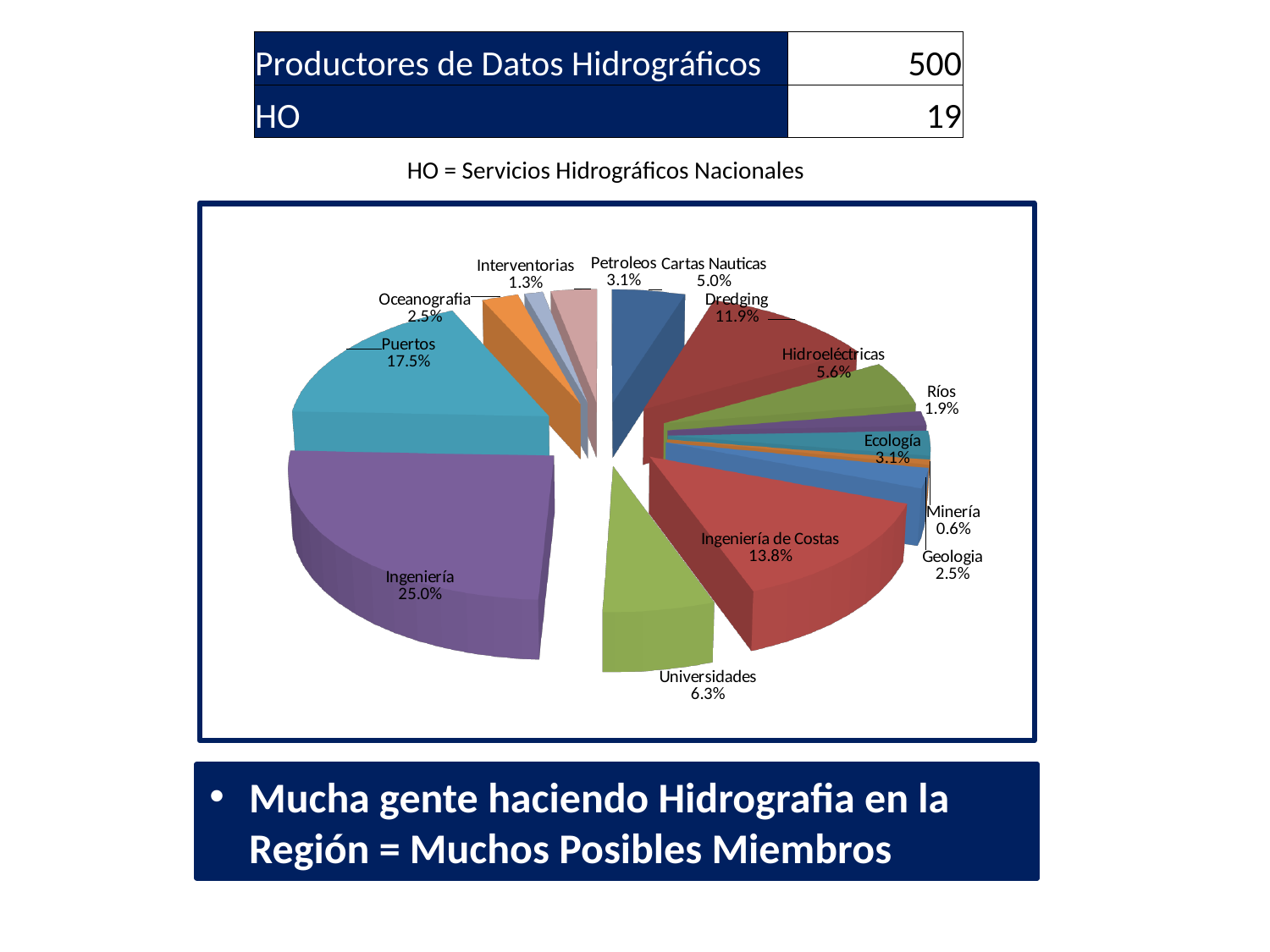
What share of the pie does Ingeniería de Costas have? 13.8% What share of the pie does Cartas Nauticas have? 5.0% How many slices does the pie chart have? 14 Which slice of the pie is the largest? Ingeniería What share of the pie does Ingeniería have? 25.0% What is the difference in percentage points between Ingeniería and Puertos? 7.5 Which slice of the pie is the smallest? Minería What kind of chart is shown on the slide? pie chart Which is larger, Dredging or Hidroeléctricas? Dredging